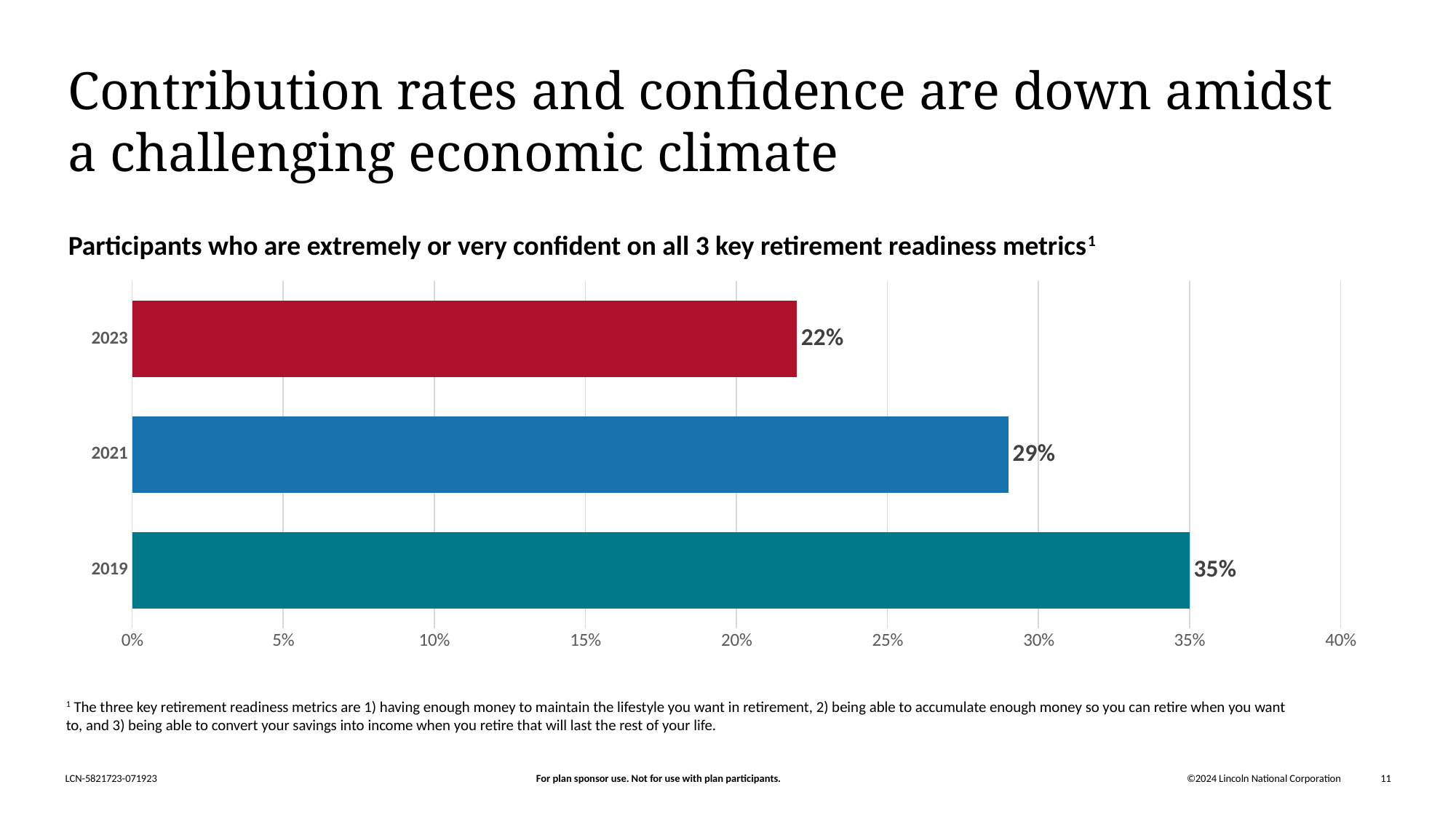
What percentage of participants were extremely or very confident on all 3 key retirement readiness metrics in 2023? 22% Which year has the lowest share of confident participants? 2023 What is the title of the chart? Participants who are extremely or very confident on all 3 key retirement readiness metrics Which year has the highest share of confident participants? 2019 How many years are shown in the chart? 3 By how many percentage points did the value fall from 2019 to 2023? 13 percentage points What is the value shown for 2021? 29% Which is larger, the value for 2021 or the value for 2023? 2021 What kind of chart is shown on the slide? Bar chart What is the difference between the 2021 and 2023 values? 7 percentage points Is the value for 2021 greater or less than 25%? greater What is the value shown for 2019? 35%